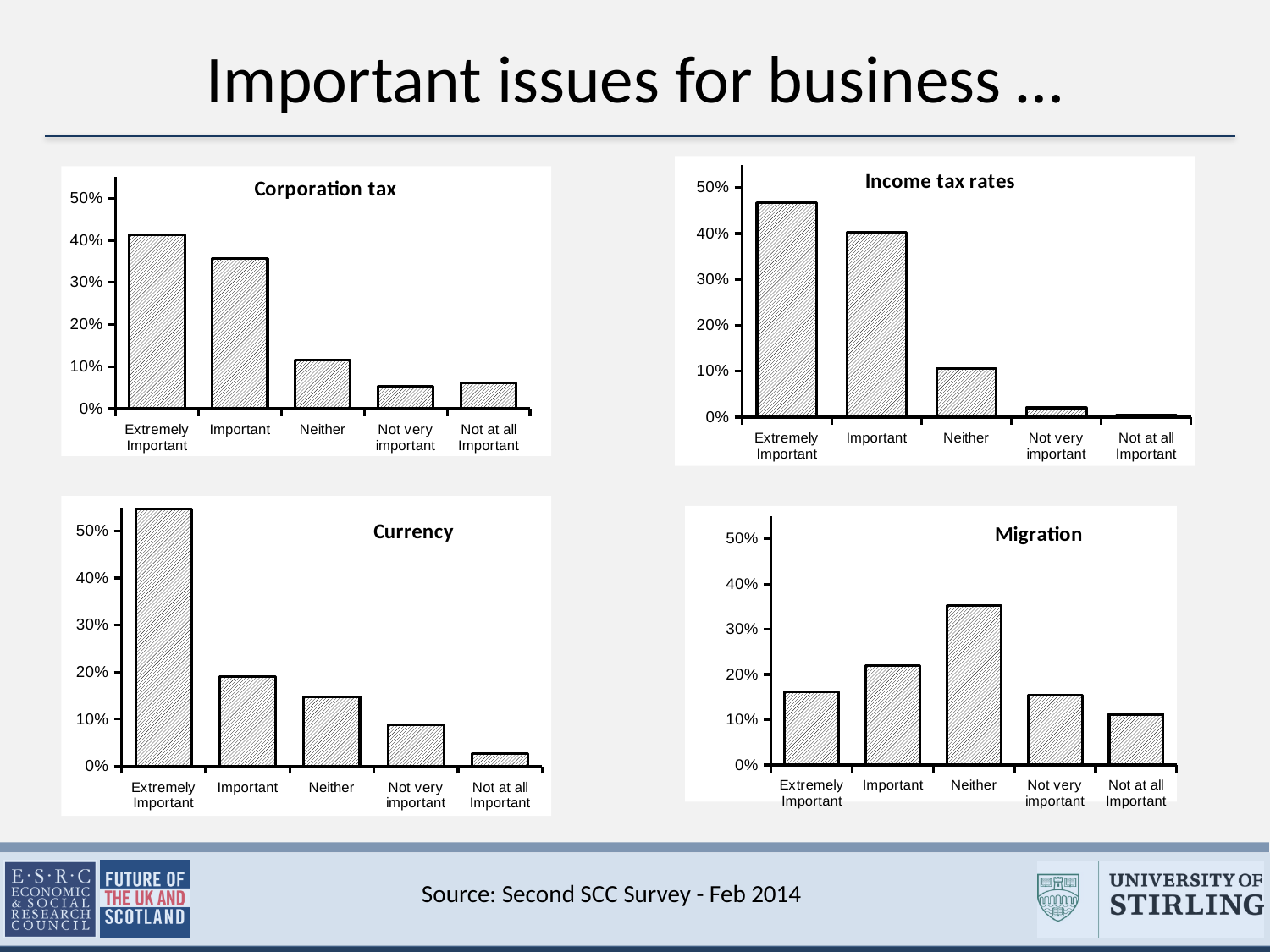
In the Currency chart, is the value for Extremely Important greater or less than 50%? greater In the Migration chart, which category has the highest value? Neither In the Migration chart, which is larger, the value for Important or the value for Extremely Important? Important In the Income tax rates chart, which is larger, the value for Important or the value for Neither? Important Do the values in the Currency chart rise or fall from left to right along the x axis? fall In the Migration chart, which category has the lowest value? Not at all Important What kind of chart is the Corporation tax chart? bar chart In the Currency chart, which category has the lowest value? Not at all Important In the Income tax rates chart, is the value for Extremely Important greater or less than 40%? greater In the Corporation tax chart, is the value for Neither greater or less than 20%? less In the Corporation tax chart, which category has the highest value? Extremely Important How many categories are shown on the x axis of the Migration chart? 5